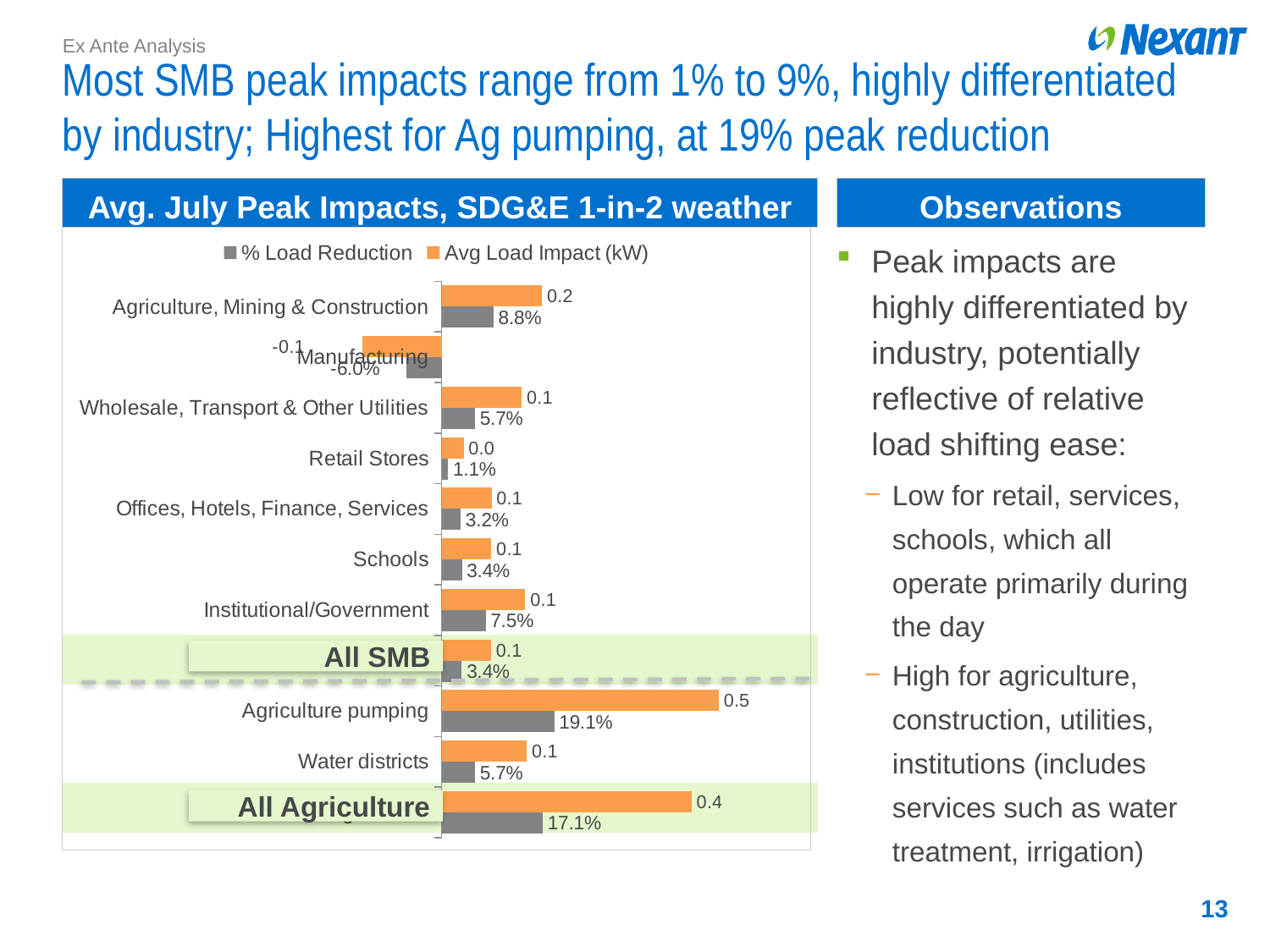
Which category has the lowest % Load Reduction? Manufacturing What is the title of the chart? Avg. July Peak Impacts, SDG&E 1-in-2 weather How many categories are shown on the chart? 11 Which category has the highest % Load Reduction? Agriculture pumping What kind of chart is shown on the slide? Bar chart What is the % Load Reduction for Agriculture pumping? 19.1% What is the % Load Reduction for Manufacturing? -6.0% What is the difference in % Load Reduction between Agriculture pumping and All Agriculture? 2.0% What is the Avg Load Impact (kW) for Agriculture, Mining & Construction? 0.2 What is the % Load Reduction for All SMB? 3.4% How many series does the legend list? 2 Which has a larger % Load Reduction, Institutional/Government or Schools? Institutional/Government